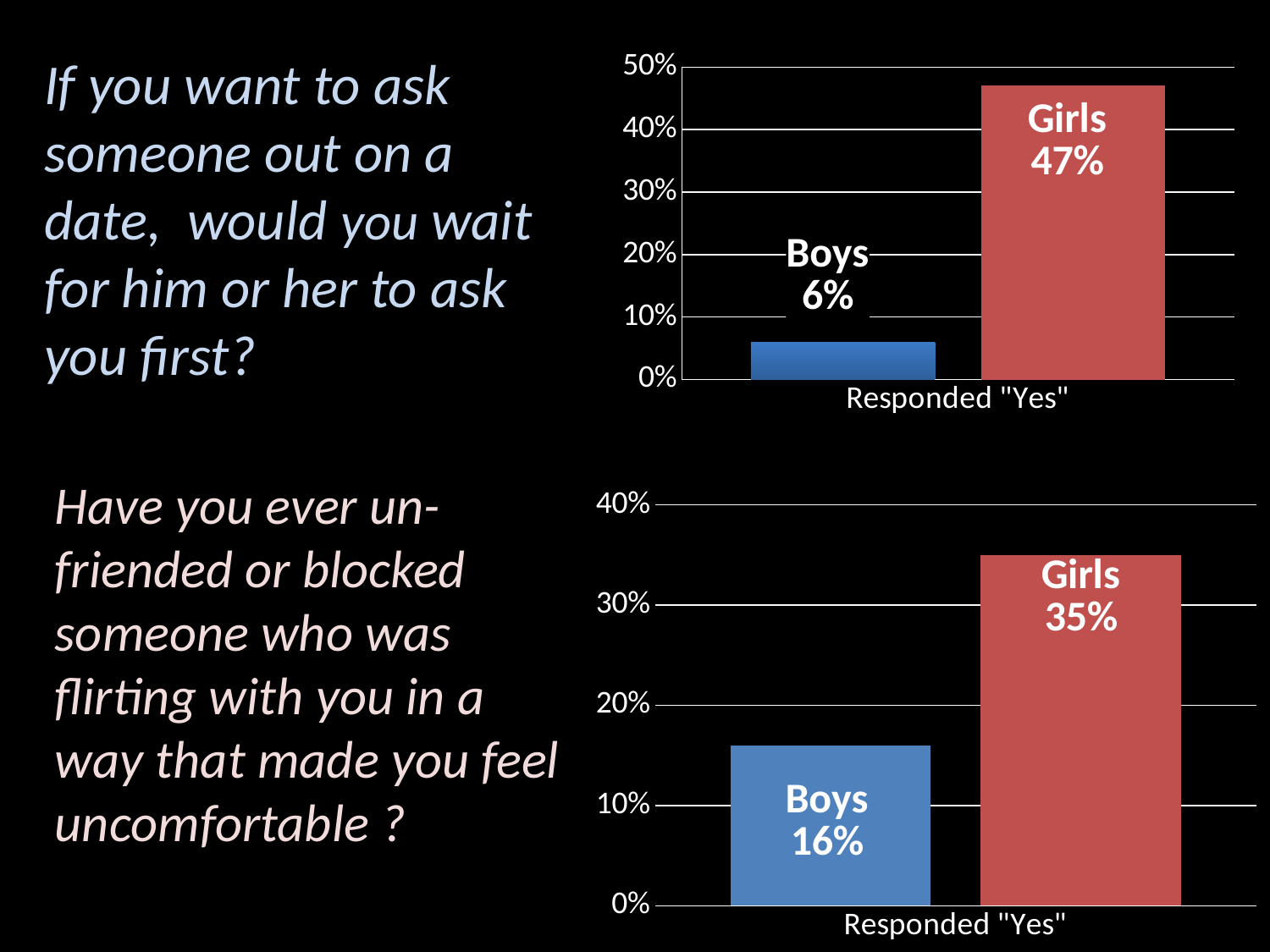
In the bottom chart, what percentage of girls responded "Yes"? 35% In the top chart, what percentage of boys responded "Yes"? 6% In the bottom chart, which group has the lower value? Boys In the top chart, what is the label on the x axis under the bars? Responded "Yes" In the top chart, what is the difference between the girls' and boys' values? 41% In the bottom chart, what percentage of boys responded "Yes"? 16% What kind of chart is the top chart? Bar chart In the bottom chart, is the value for boys greater or less than 20%? less In the top chart, which group has the higher value? Girls How many bars are shown in the bottom chart? 2 In the top chart, what percentage of girls responded "Yes"? 47% In the bottom chart, what is the difference between the girls' and boys' values? 19%